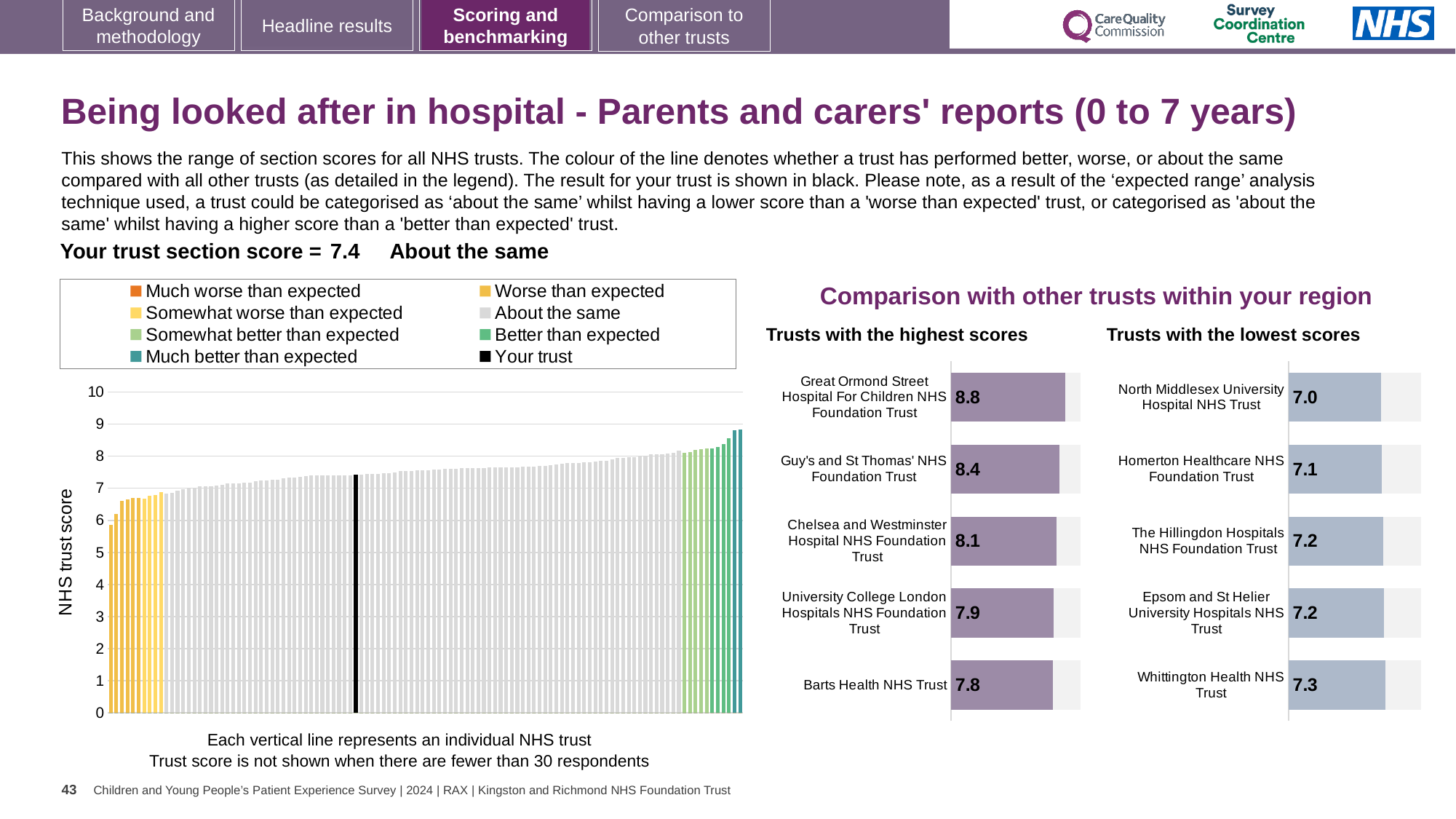
In the 'Trusts with the highest scores' chart, what is the score for Great Ormond Street Hospital For Children NHS Foundation Trust? 8.8 In the 'Trusts with the highest scores' chart, which trust has the lowest score? Barts Health NHS Trust In the 'Trusts with the lowest scores' chart, which has the larger score: Homerton Healthcare NHS Foundation Trust or Whittington Health NHS Trust? Whittington Health NHS Trust In the large chart on the left showing all NHS trusts, what kind of chart is it? Bar chart In the 'Trusts with the highest scores' chart, what is the difference between the scores of Great Ormond Street Hospital For Children NHS Foundation Trust and Barts Health NHS Trust? 1.0 In the 'Trusts with the highest scores' chart, what is the score for Barts Health NHS Trust? 7.8 In the 'Trusts with the lowest scores' chart, what is the score for North Middlesex University Hospital NHS Trust? 7.0 In the 'Trusts with the lowest scores' chart, which trust has the highest score? Whittington Health NHS Trust In the 'Trusts with the lowest scores' chart, how many trusts are shown? 5 In the large chart on the left showing all NHS trusts, is the value for 'Your trust' greater or less than 7? greater In the large chart on the left showing all NHS trusts, do the trust scores rise or fall from left to right? Rise In the large chart on the left showing all NHS trusts, how many entries does the legend list? 8